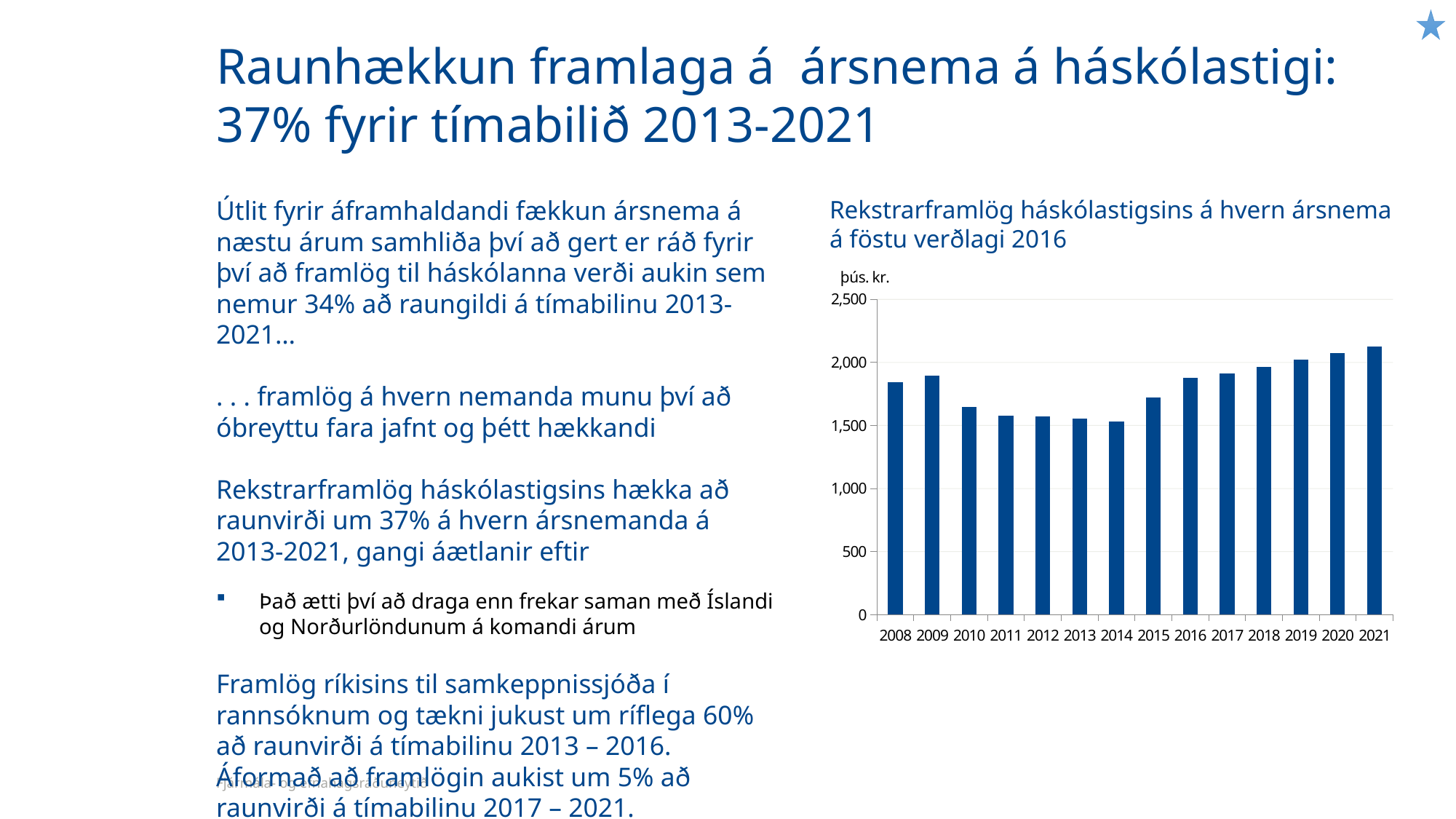
Is the value for 2010 greater or less than 2,000? less Is the value for 2021 greater or less than 2,000? greater What is the title of the chart? Rekstrarframlög háskólastigsins á hvern ársnema á föstu verðlagi 2016 Do the values rise or fall from 2014 to 2021? rise Is the value for 2008 greater or less than 1,500? greater Which is larger, the value for 2009 or the value for 2010? 2009 Which year has the highest value in the chart? 2021 What unit is shown above the y axis of the chart? þús. kr. Which is larger, the value for 2014 or the value for 2021? 2021 What kind of chart is shown on the slide? bar chart How many years are shown on the x axis of the chart? 14